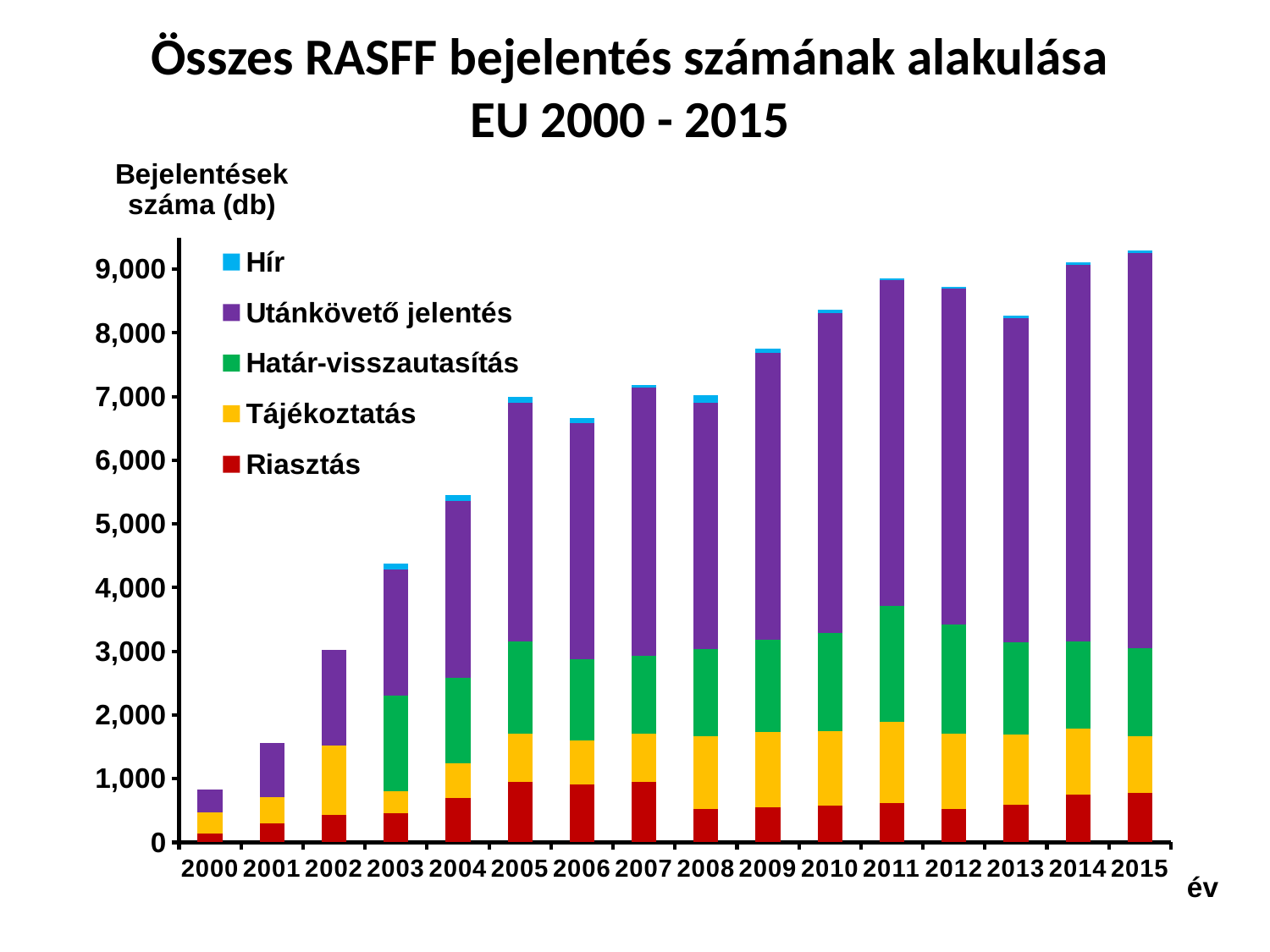
Is the total value for 2000 greater or less than 1,000? less Is the total value for 2004 greater or less than 5,000? greater What is the title of the chart? Összes RASFF bejelentés számának alakulása EU 2000 - 2015 Do the total values generally rise or fall from 2000 to 2015? rise Is the total value for 2006 greater or less than 7,000? less Which year has a larger total, 2013 or 2014? 2014 How many years (categories) are shown on the x axis? 16 How many series does the legend list? 5 Which year has the highest total number of notifications? 2015 What kind of chart is shown on the slide? stacked bar chart Which year has the lowest total number of notifications? 2000